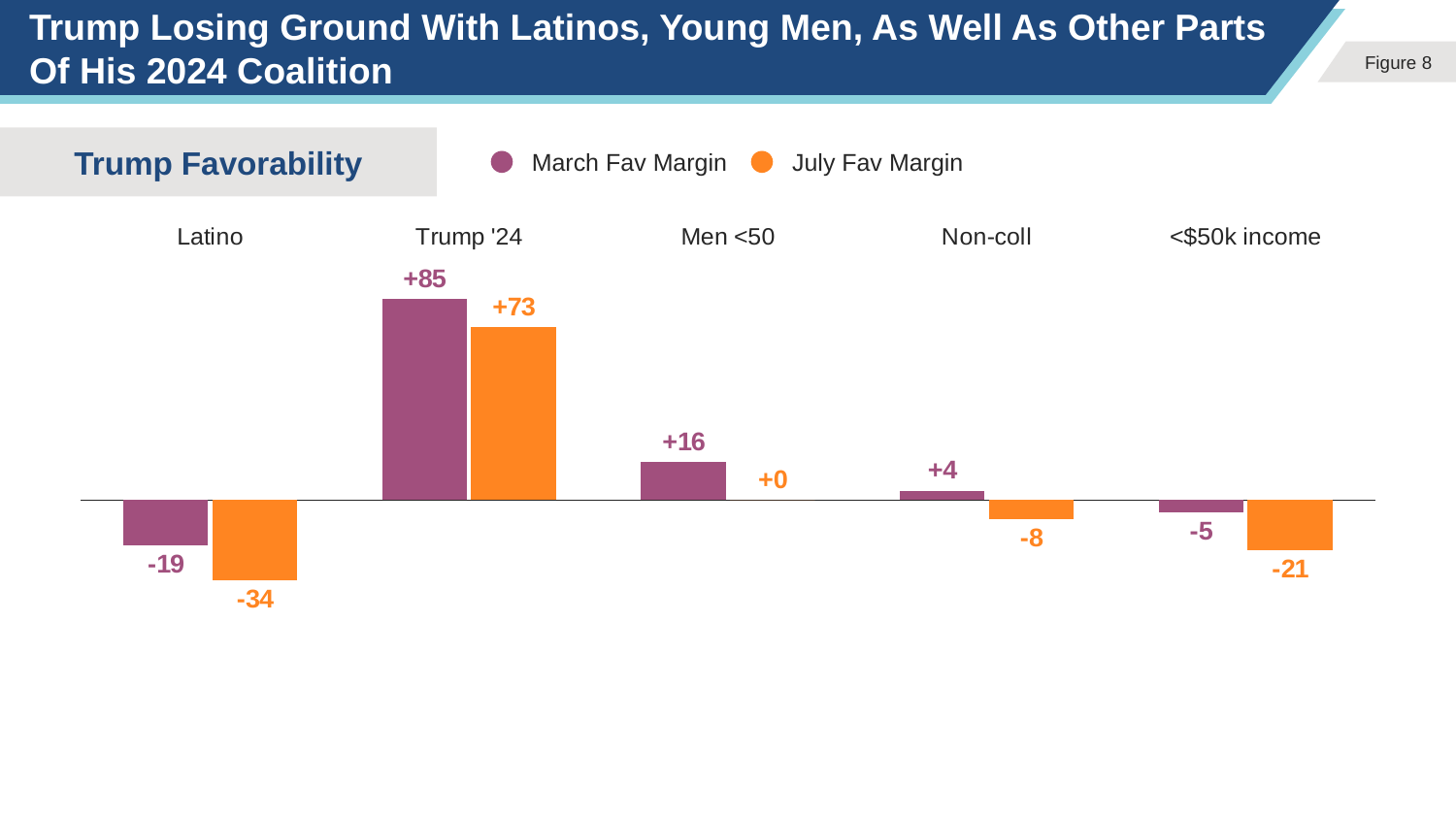
What is the March Fav Margin for Non-coll? +4 Which category has the highest March Fav Margin? Trump '24 What is the July Fav Margin for Trump '24? +73 What is the difference between the March Fav Margin and the July Fav Margin for Latino? 15 How many series does the legend list? 2 What is the July Fav Margin for <$50k income? -21 How many categories are shown on the x axis? 5 Which is larger for <$50k income, the March Fav Margin or the July Fav Margin? March Fav Margin What kind of chart is shown? Bar chart Which category has the lowest July Fav Margin? Latino What is the March Fav Margin for Latino? -19 What is the July Fav Margin for Men <50? +0